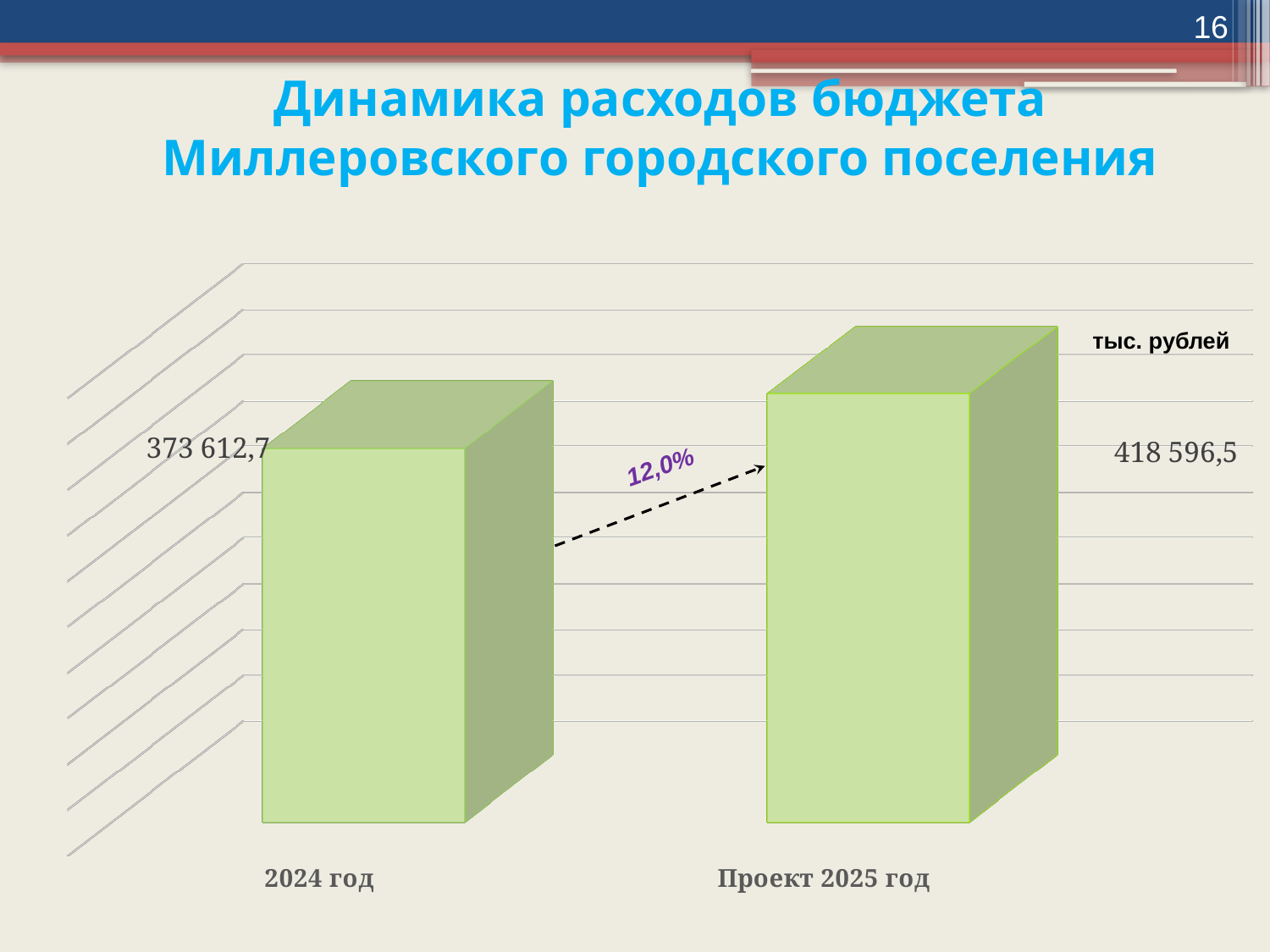
Which is larger, the value for 2024 год or the value for Проект 2025 год? Проект 2025 год How many categories are shown in the chart? 2 What is the value for 2024 год? 373 612,7 What kind of chart is shown on the slide? Bar chart What is the difference between the values for Проект 2025 год and 2024 год? 44 983,8 What is the title of the chart? Динамика расходов бюджета Миллеровского городского поселения What unit of measurement is indicated on the chart? тыс. рублей What percentage change is shown on the arrow between the two bars? 12,0% Which category has the lowest value? 2024 год Do the values rise or fall from 2024 год to Проект 2025 год? Rise What is the value for Проект 2025 год? 418 596,5 Which category has the highest value? Проект 2025 год